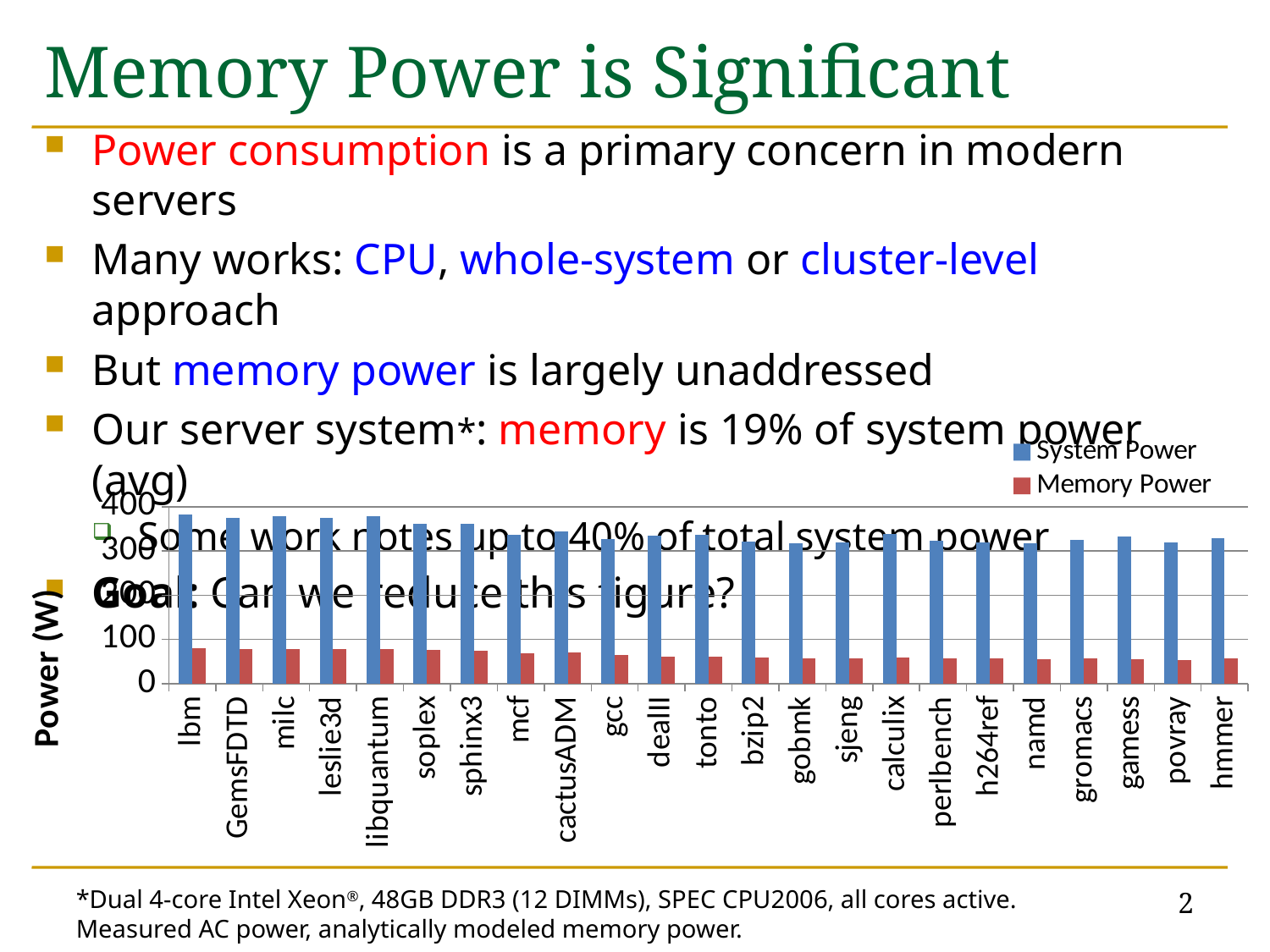
How many benchmark categories are plotted along the x axis of the chart? 23 Which is larger: the System Power for lbm or the System Power for povray? lbm Is the System Power value for gobmk greater or less than 200? greater Do the System Power values generally rise or fall moving from left to right along the x axis? fall How many series does the chart legend list? 2 What is the label of the chart's vertical axis? Power (W) Is the System Power value for lbm greater or less than 300? greater What are the two series named in the chart legend? System Power and Memory Power Is the Memory Power value for hmmer greater or less than 100? less For the benchmark mcf, which is larger: System Power or Memory Power? System Power What kind of chart is shown on the slide? bar chart